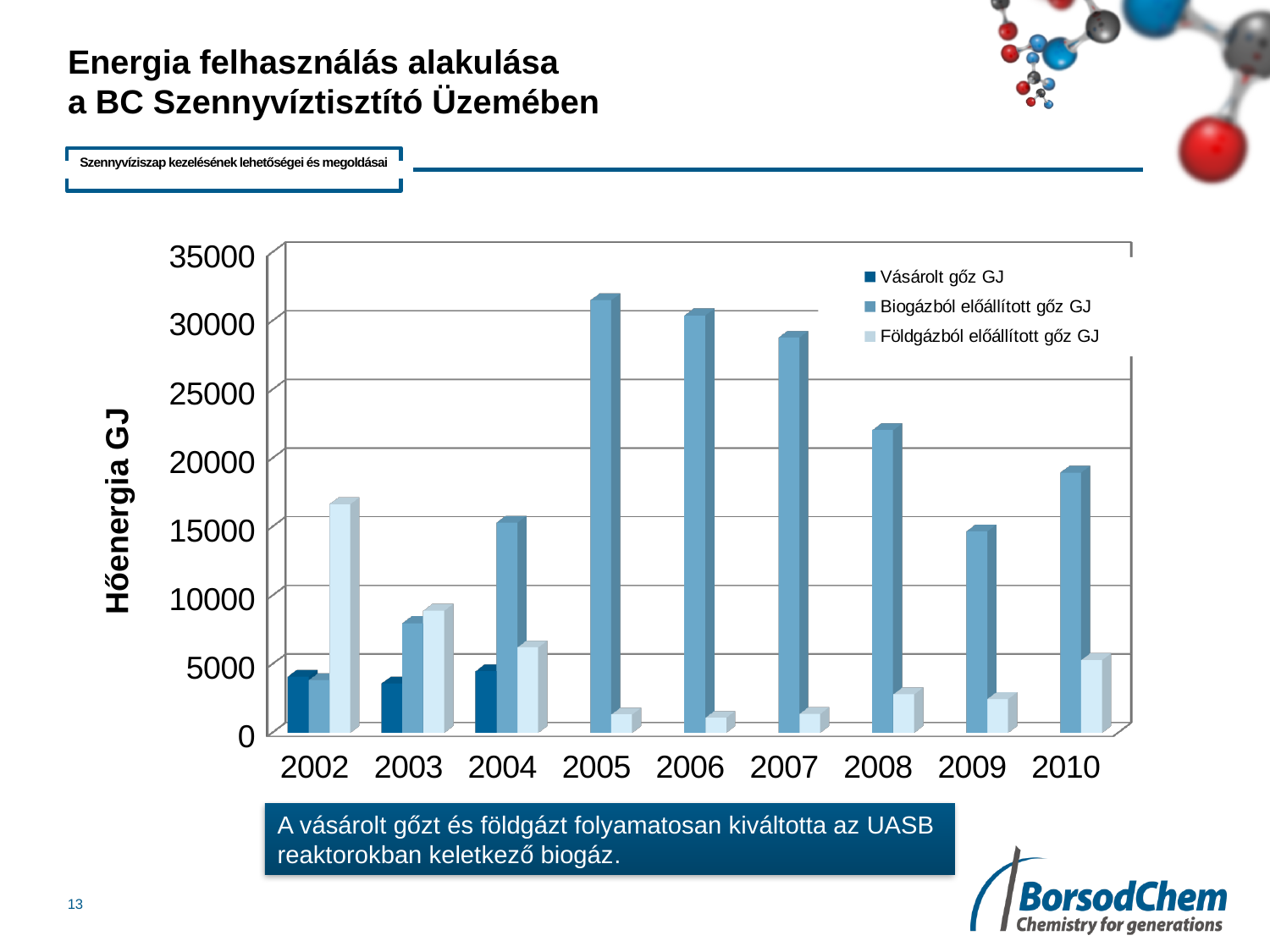
Is the value for Biogázból előállított gőz GJ in 2005 greater or less than 30000? greater How many years are shown on the x axis of the chart? 9 Does the value for Biogázból előállított gőz GJ rise or fall from 2005 to 2009? fall What kind of chart is shown on the slide? bar chart Is the value for Biogázból előállított gőz GJ in 2008 greater or less than 20000? greater Which is larger in 2010: Biogázból előállított gőz GJ or Földgázból előállított gőz GJ? Biogázból előállított gőz GJ Which is larger in 2002: Vásárolt gőz GJ or Földgázból előállított gőz GJ? Földgázból előállított gőz GJ How many series does the chart's legend list? 3 What is the title of the chart's vertical axis? Hőenergia GJ Is the value for Földgázból előállított gőz GJ in 2002 greater or less than 15000? greater In which year is the value for Biogázból előállított gőz GJ highest? 2005